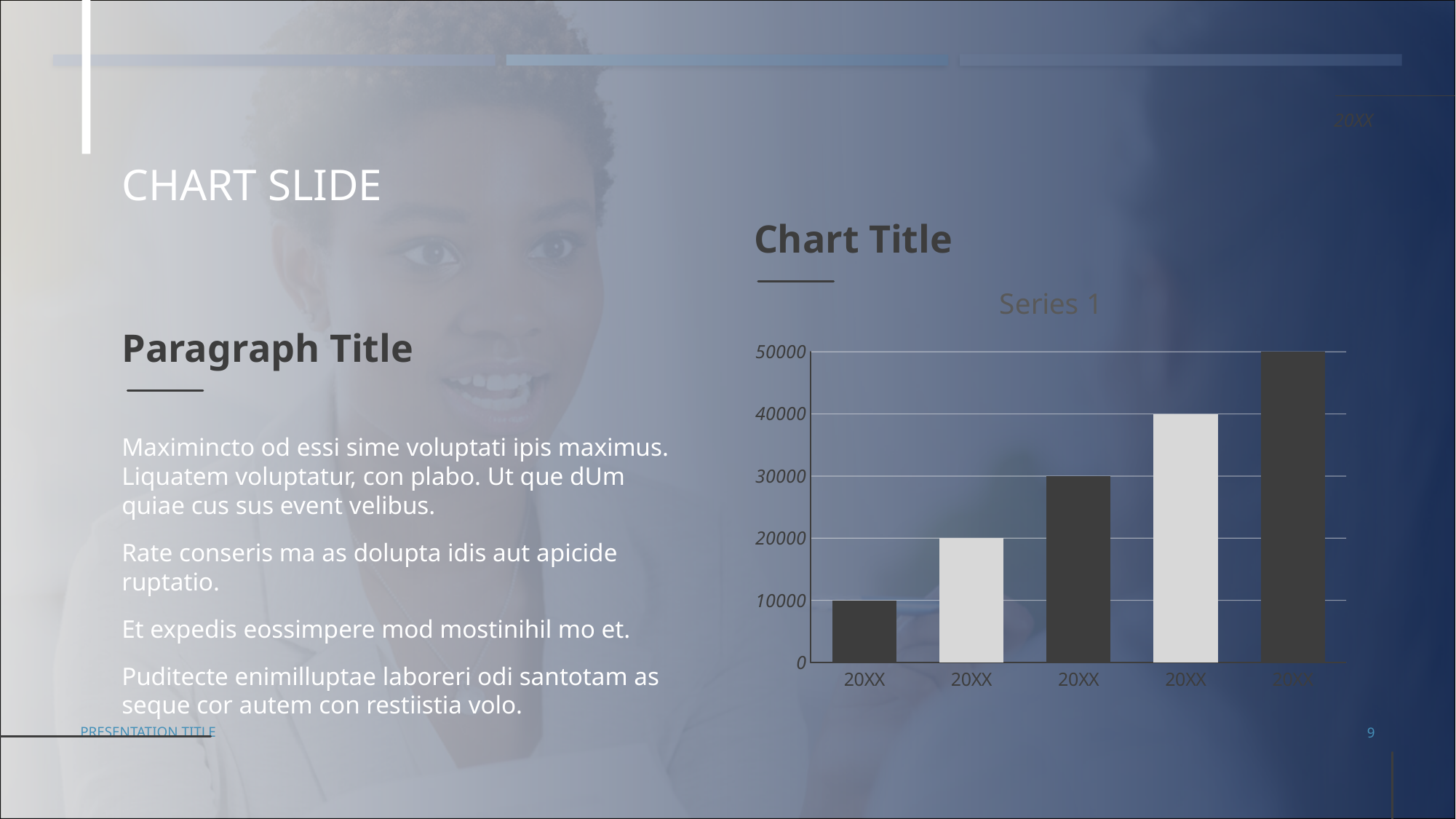
What is the title shown above the plot area of the chart? Series 1 What is the value of the first (leftmost) bar in the chart? 10000 What is the value of the third bar from the left in the chart? 30000 Which bar has the highest value in the chart? the rightmost (fifth) bar Which is larger, the second bar or the third bar in the chart? the third bar How many bars are plotted in the chart? 5 What kind of chart is shown on the slide? bar chart What is the difference between the fourth bar and the second bar in the chart? 20000 What is the value of the last (rightmost) bar in the chart? 50000 Which bar has the lowest value in the chart? the leftmost (first) bar Do the bar values rise or fall from left to right along the x axis? rise What is the highest value shown on the vertical axis of the chart? 50000